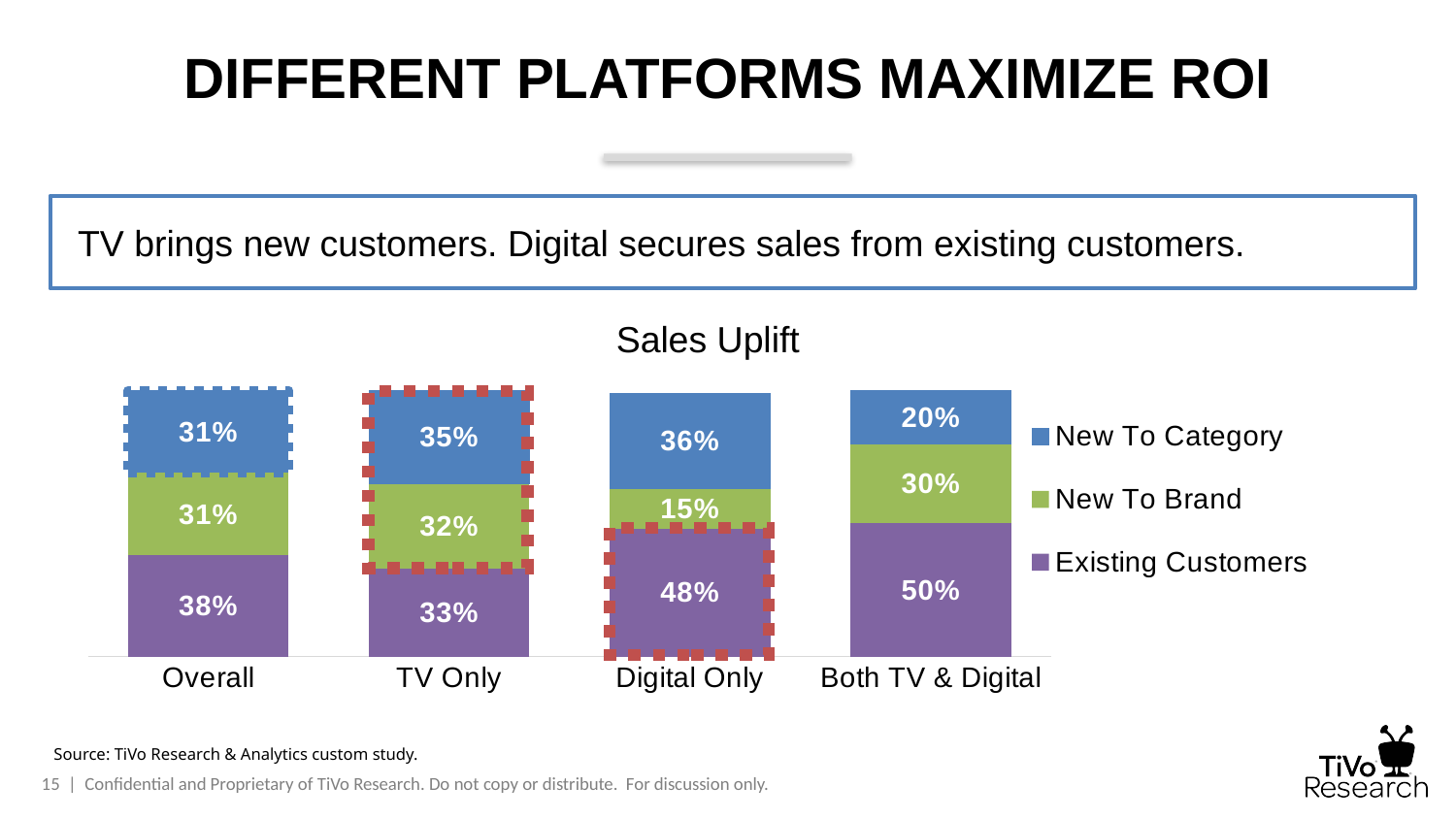
What kind of chart is the Sales Uplift chart? Stacked bar chart How many categories are shown on the x axis of the Sales Uplift chart? 4 Which series is shown in purple in the Sales Uplift chart? Existing Customers Which is larger: the Existing Customers value for Overall or for TV Only? Overall What is the total of the stacked bar for TV Only in the Sales Uplift chart? 100% What is the New To Brand value for Both TV & Digital in the Sales Uplift chart? 30% What is the New To Category value for TV Only in the Sales Uplift chart? 35% Which category has the lowest New To Brand value in the Sales Uplift chart? Digital Only What is the difference between the New To Category values for Digital Only and Both TV & Digital? 16% Which category has the highest Existing Customers value in the Sales Uplift chart? Both TV & Digital How many series does the legend of the Sales Uplift chart list? 3 What is the Existing Customers value for Digital Only in the Sales Uplift chart? 48%